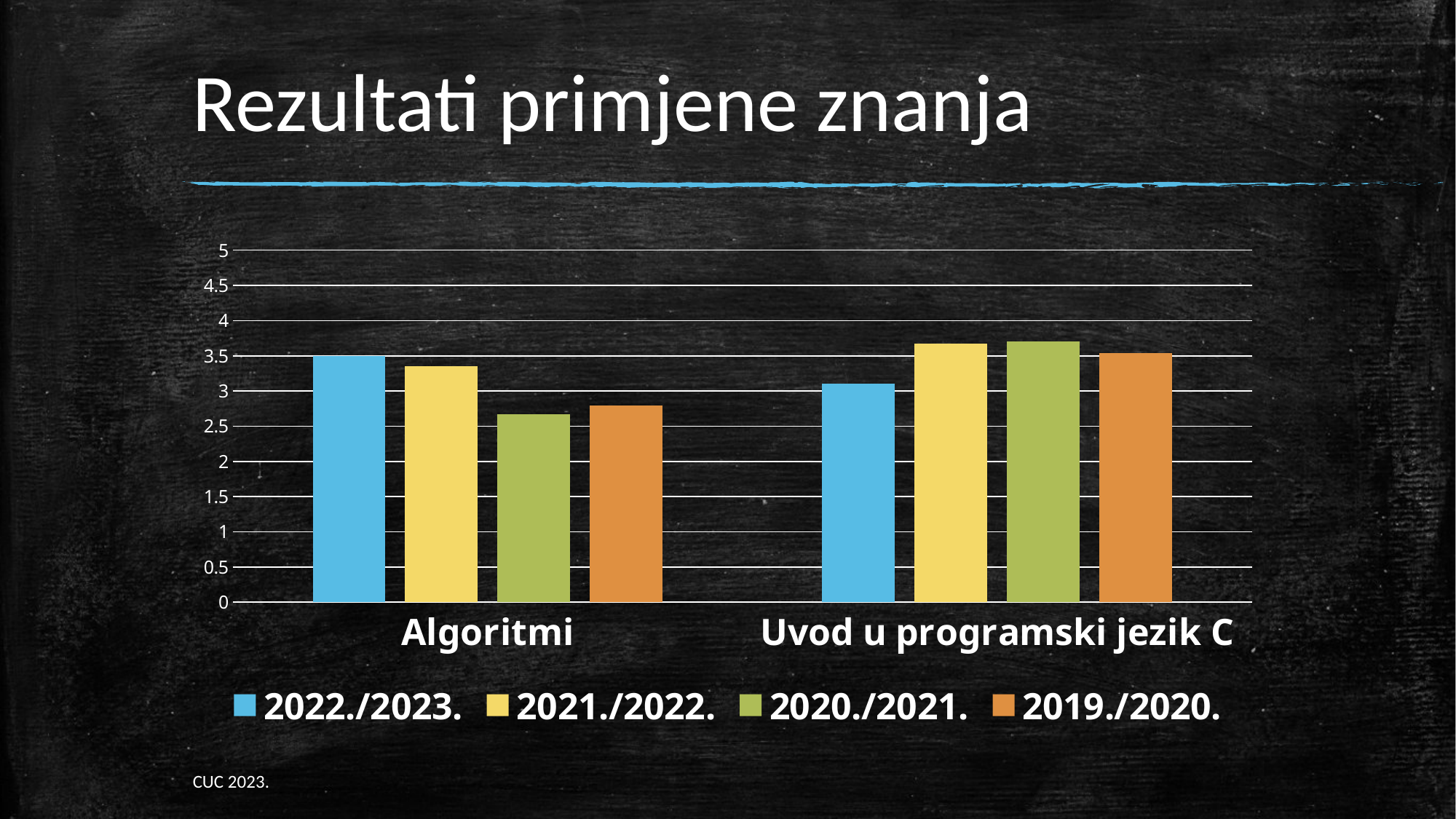
Is the value for 2021./2022. in Uvod u programski jezik C greater or less than 3.5? greater Is the value for 2022./2023. in Uvod u programski jezik C greater or less than 3? greater For the 2019./2020. series, which category has the larger value, Algoritmi or Uvod u programski jezik C? Uvod u programski jezik C How many categories are shown on the x axis? 2 Which series has the highest value for Algoritmi? 2022./2023. Which series has the lowest value for Algoritmi? 2020./2021. What kind of chart is shown on the slide? bar chart Which series has the lowest value for Uvod u programski jezik C? 2022./2023. Is the value for 2020./2021. in Algoritmi greater or less than 3? less For the 2022./2023. series, which category has the larger value, Algoritmi or Uvod u programski jezik C? Algoritmi What is the title of the slide containing the chart? Rezultati primjene znanja How many series does the legend list? 4